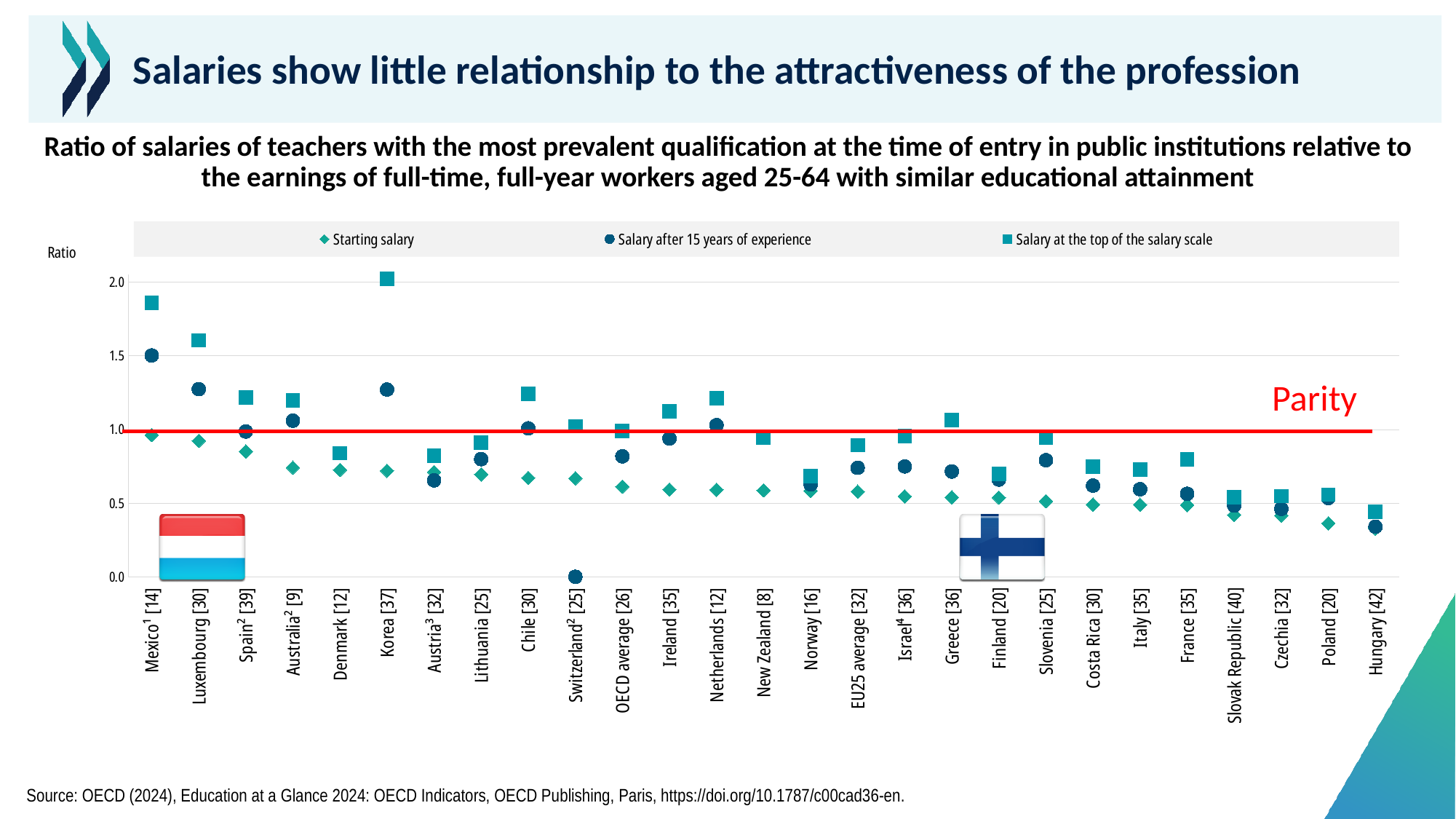
Is the value for Salary after 15 years of experience for Luxembourg greater or less than 1.0? greater Is the value for Salary at the top of the salary scale for Denmark greater or less than 1.0? less What label is given to the red horizontal line at 1.0? Parity Which is larger: the Salary after 15 years of experience for Korea or for Chile? Korea Which category has the highest value for Salary at the top of the salary scale? Korea [37] Is the Starting salary value for Hungary greater or less than 0.5? less Do the Starting salary values generally rise or fall from left to right along the x axis? fall How many series does the legend list? 3 Which is larger: the Salary at the top of the salary scale for Mexico or for Luxembourg? Mexico How many countries or averages are shown along the x axis? 27